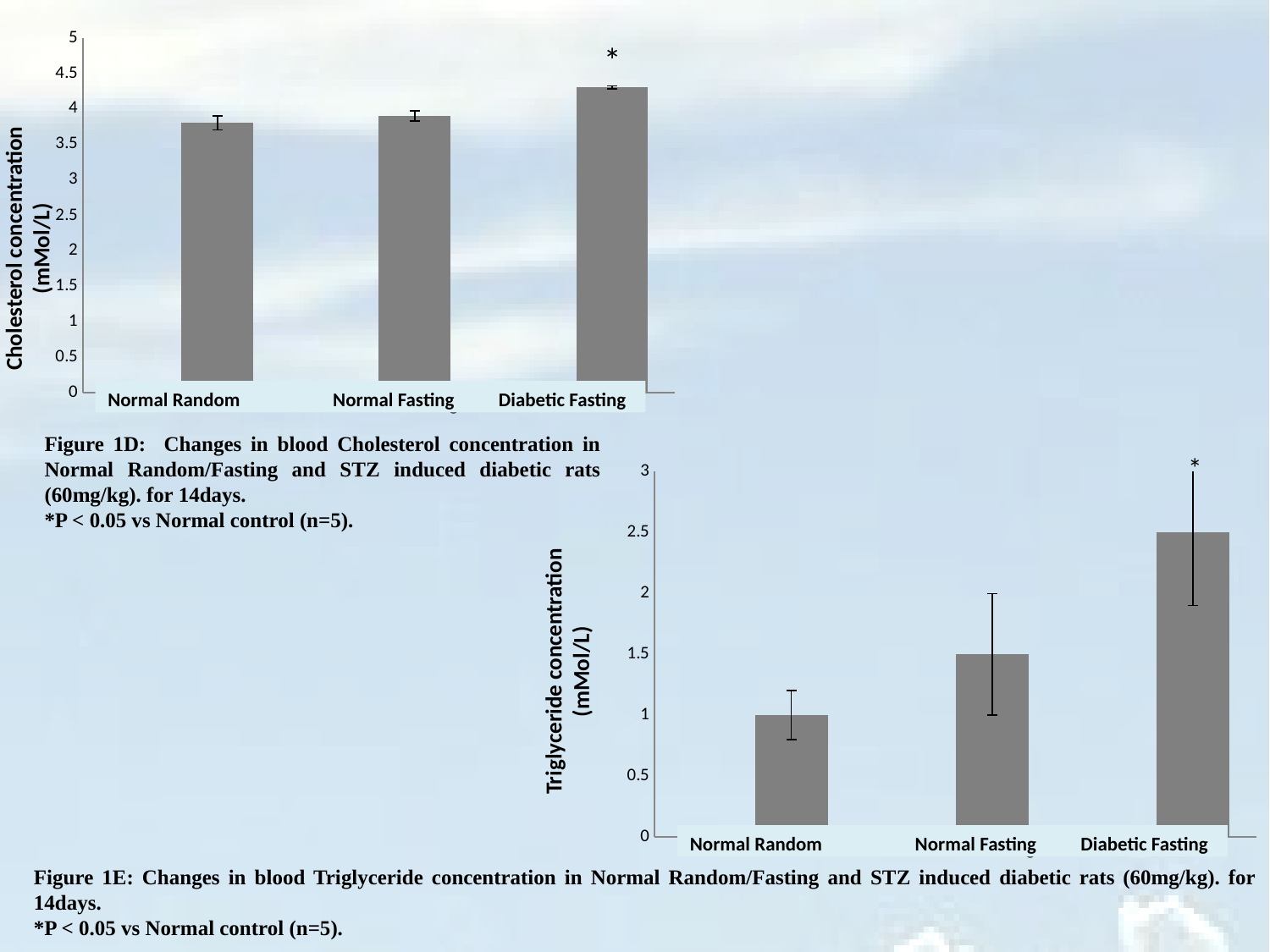
In the Figure 1E triglyceride chart, which category has the lowest triglyceride concentration? Normal Random What kind of chart is Figure 1D? bar chart In the Figure 1E triglyceride chart, do the values rise or fall from Normal Random to Diabetic Fasting? rise What is the y-axis label of the Figure 1E chart? Triglyceride concentration (mMol/L) In the Figure 1E triglyceride chart, which category has the highest triglyceride concentration? Diabetic Fasting In the Figure 1D cholesterol chart, which category has the highest cholesterol concentration? Diabetic Fasting In the Figure 1D cholesterol chart, is the value for Diabetic Fasting greater or less than 4? greater In the Figure 1E triglyceride chart, is the value for Diabetic Fasting greater or less than 2? greater In the Figure 1D cholesterol chart, is the value for Normal Random greater or less than 4? less In the Figure 1E triglyceride chart, which is larger, the value for Normal Fasting or Normal Random? Normal Fasting In the Figure 1D cholesterol chart, how many categories are plotted? 3